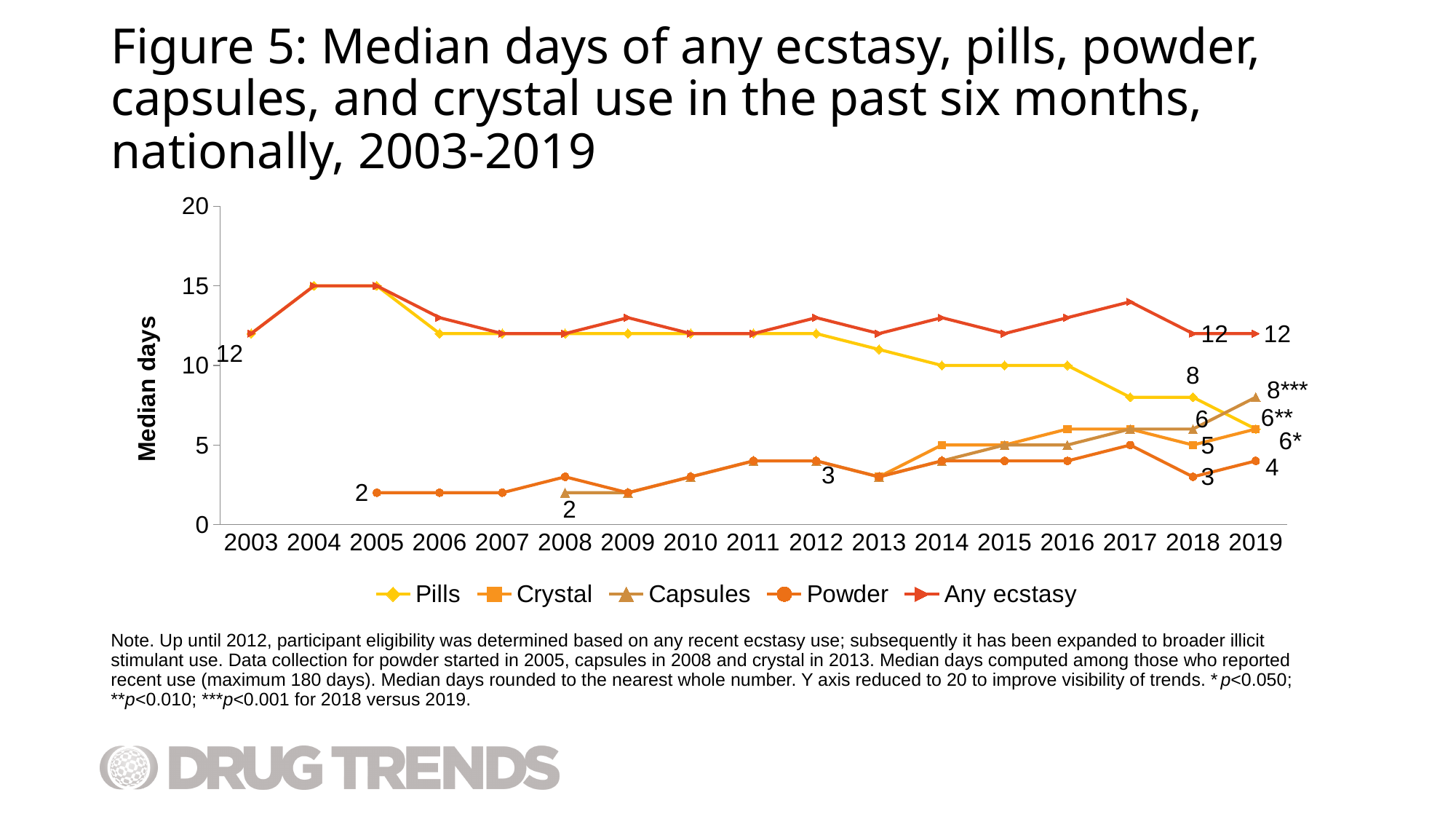
What is the difference between Any ecstasy and Pills in 2018? 4 Is the value for Any ecstasy in 2004 greater or less than 10? greater What is the median days value for Pills in 2018? 8 Does the Pills line rise or fall from 2012 to 2019? Falls Which series has the highest value in 2019? Any ecstasy What kind of chart is shown on the slide? Line chart What is the median days value for Powder in 2019? 4 What is the median days value for Crystal in 2018? 5 What is the median days value for Any ecstasy in 2019? 12 How many series does the legend list? 5 How many years are shown along the x axis? 17 Which series has the lowest value in 2018? Powder